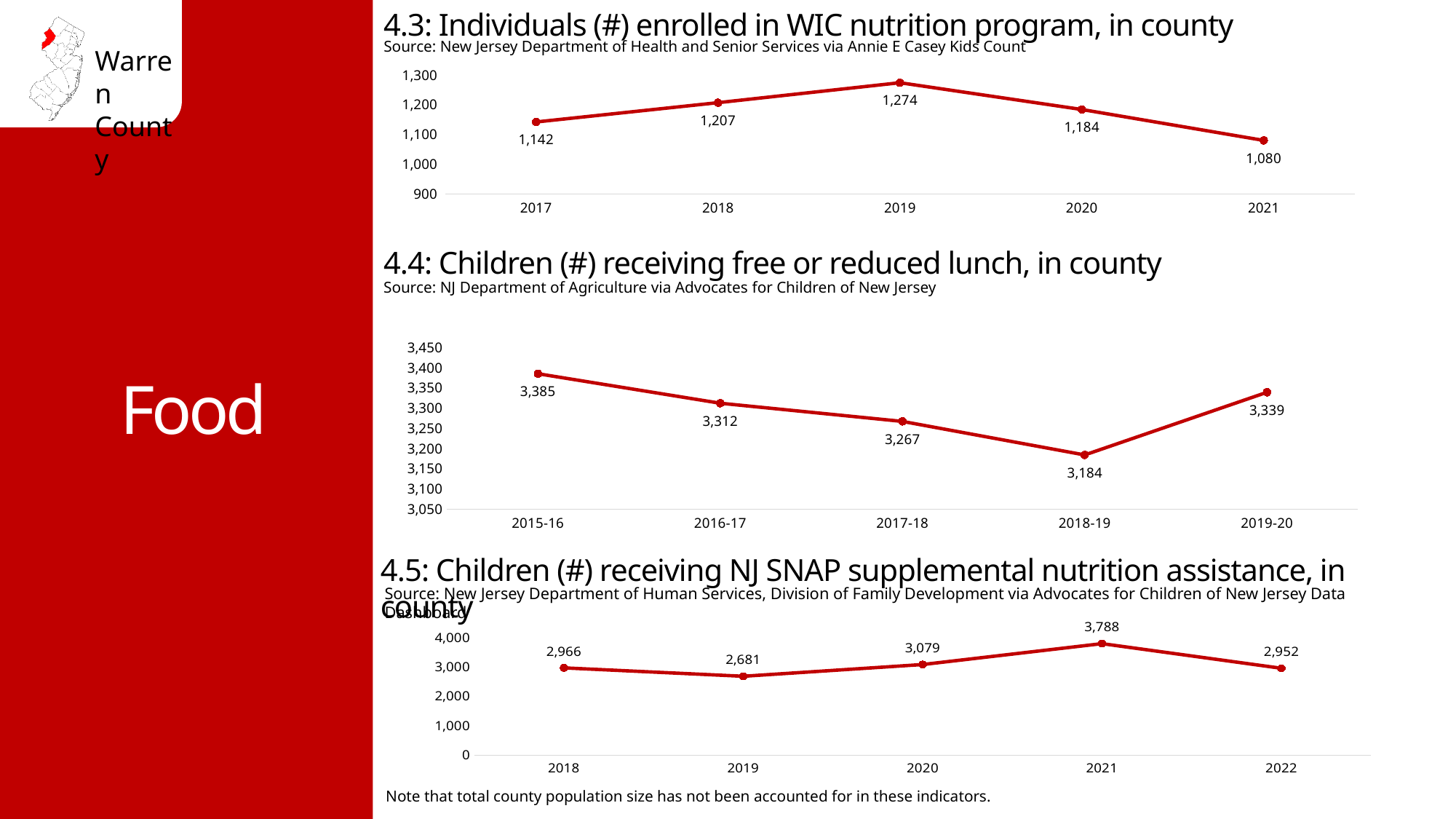
In the chart '4.5: Children (#) receiving NJ SNAP supplemental nutrition assistance, in county', what is the difference between the 2021 and 2022 values? 836 In the chart '4.4: Children (#) receiving free or reduced lunch, in county', do values rise or fall from 2015-16 to 2018-19? fall In the chart '4.3: Individuals (#) enrolled in WIC nutrition program, in county', what is the difference between the 2019 and 2021 values? 194 In the chart '4.3: Individuals (#) enrolled in WIC nutrition program, in county', what is the value for 2019? 1,274 In the chart '4.5: Children (#) receiving NJ SNAP supplemental nutrition assistance, in county', what is the value for 2021? 3,788 In the chart '4.4: Children (#) receiving free or reduced lunch, in county', which is larger, the value for 2016-17 or 2019-20? 2019-20 In the chart '4.3: Individuals (#) enrolled in WIC nutrition program, in county', which year has the lowest value? 2021 In the chart '4.5: Children (#) receiving NJ SNAP supplemental nutrition assistance, in county', which year has the lowest value? 2019 In the chart '4.3: Individuals (#) enrolled in WIC nutrition program, in county', how many data points are plotted? 5 What kind of chart is '4.5: Children (#) receiving NJ SNAP supplemental nutrition assistance, in county'? line chart In the chart '4.4: Children (#) receiving free or reduced lunch, in county', what is the value for 2018-19? 3,184 In the chart '4.4: Children (#) receiving free or reduced lunch, in county', which school year has the highest value? 2015-16